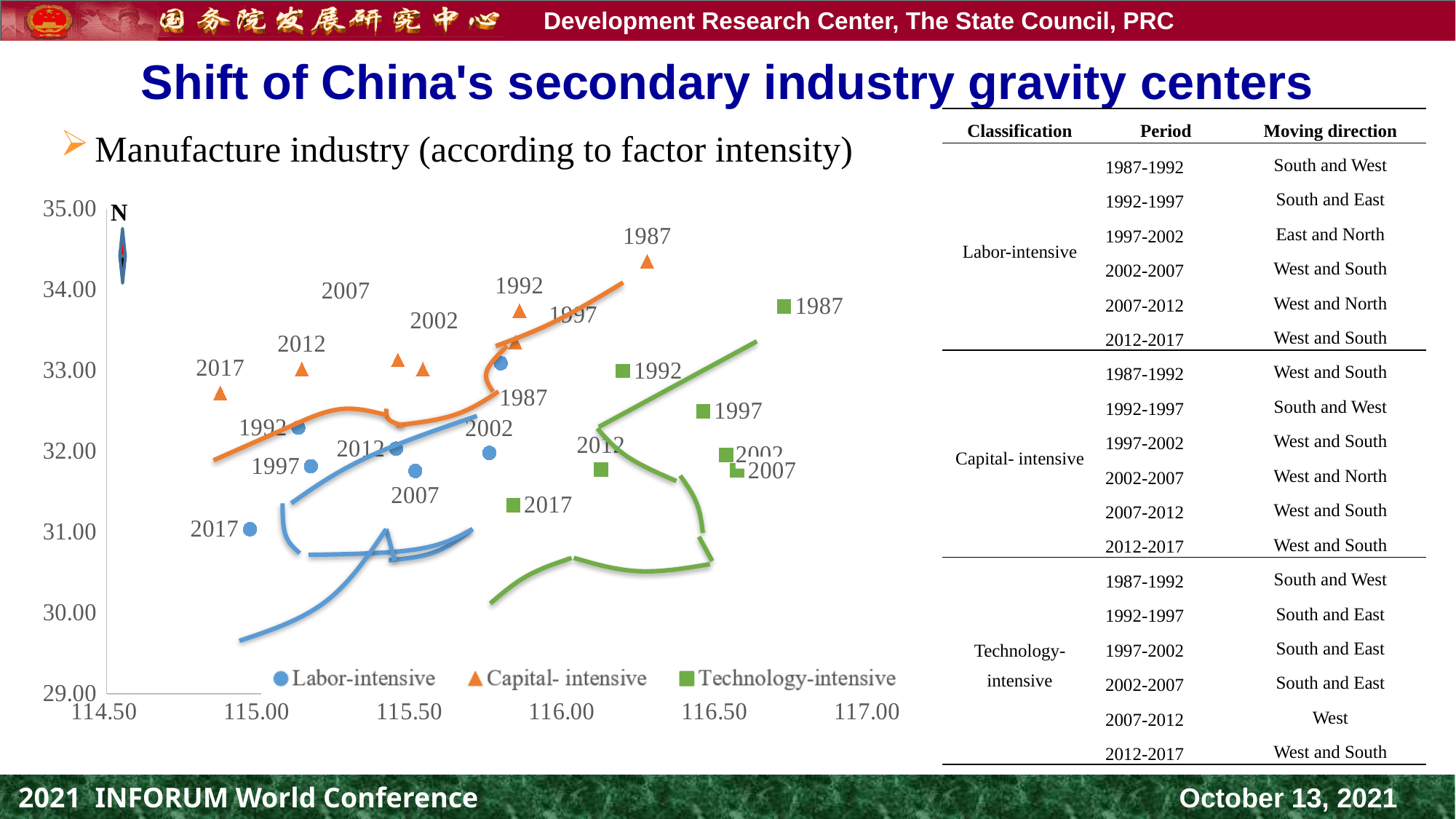
What kind of chart is shown on the slide? Scatter chart From 1987 to 2017, does the latitude (y value) of the Labor-intensive series rise or fall overall? Fall Is the longitude (x value) of the Technology-intensive 1987 point greater or less than 116.50? greater Is the latitude (y value) of the Capital- intensive 1987 point greater or less than 34.00? greater Which series has the 1987 point with the highest latitude (y value)? Capital- intensive How many series does the chart legend list? 3 How many labelled year points does the Labor-intensive series have? 7 Which marker shape is used for the Capital- intensive series? Triangle Which series are listed in the chart legend? Labor-intensive, Capital- intensive, Technology-intensive Which has the larger longitude (x value): the Technology-intensive 1992 point or the Labor-intensive 1992 point? Technology-intensive 1992 Is the latitude (y value) of the Labor-intensive 2017 point greater or less than 32.00? less